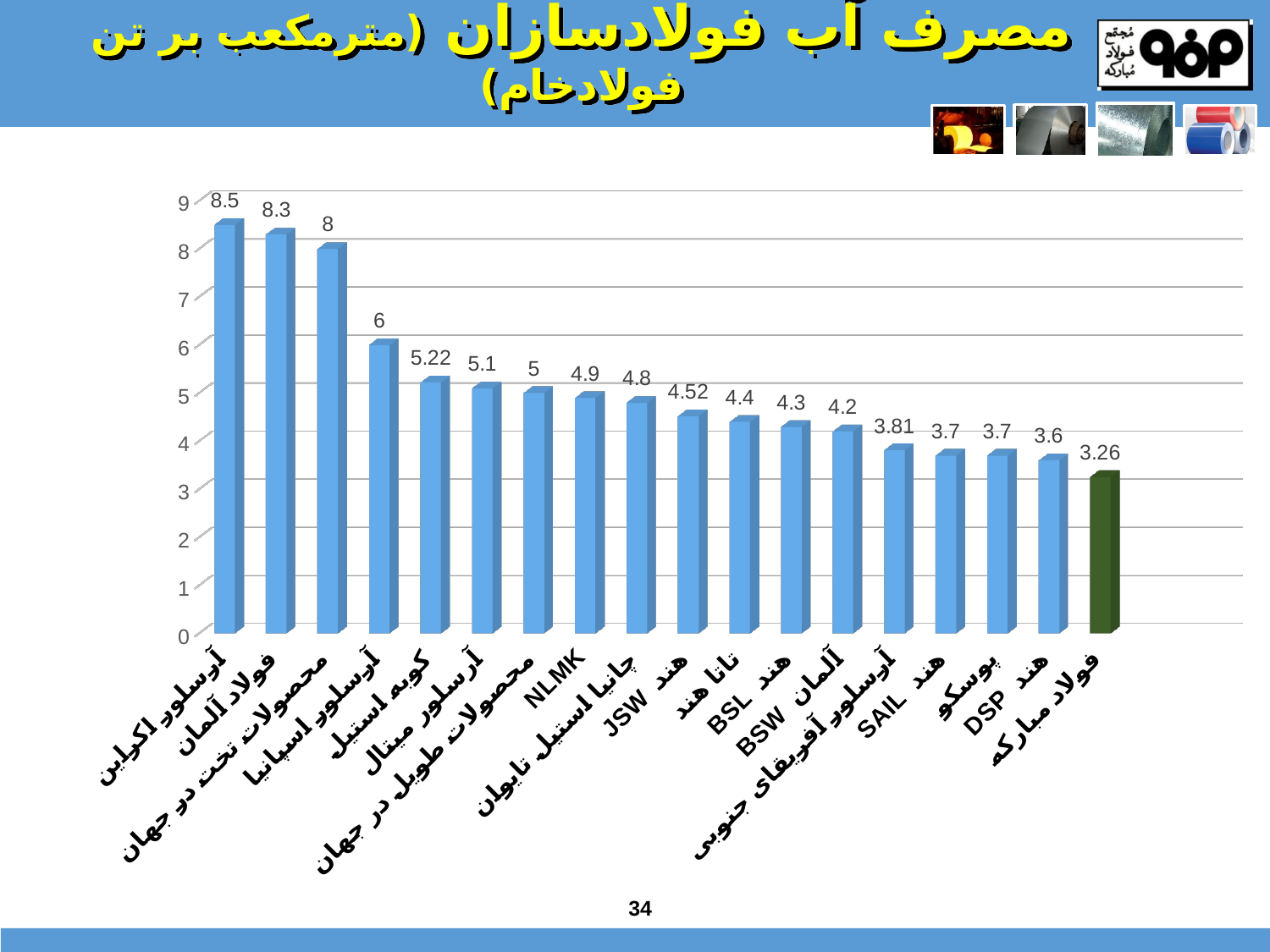
What is the difference between the values for JSW هند and تاتا هند? 0.12 Which category has the highest value? آرسلور اکراین What is the value for آرسلور آفریقای جنوبی? 3.81 What kind of chart is shown on the slide? bar chart Which category has the lowest value? فولاد مبارکه What is the value for فولاد مبارکه? 3.26 What is the difference between the values for آرسلور اکراین and فولاد مبارکه? 5.24 How many bars are shown in the chart? 18 What is the value for NLMK? 4.9 Which bar is shown in a different colour (green) from the others? فولاد مبارکه Which is larger, the value for فولاد آلمان or the value for آرسلور اسپانیا? فولاد آلمان What is the value for کوبه استیل? 5.22